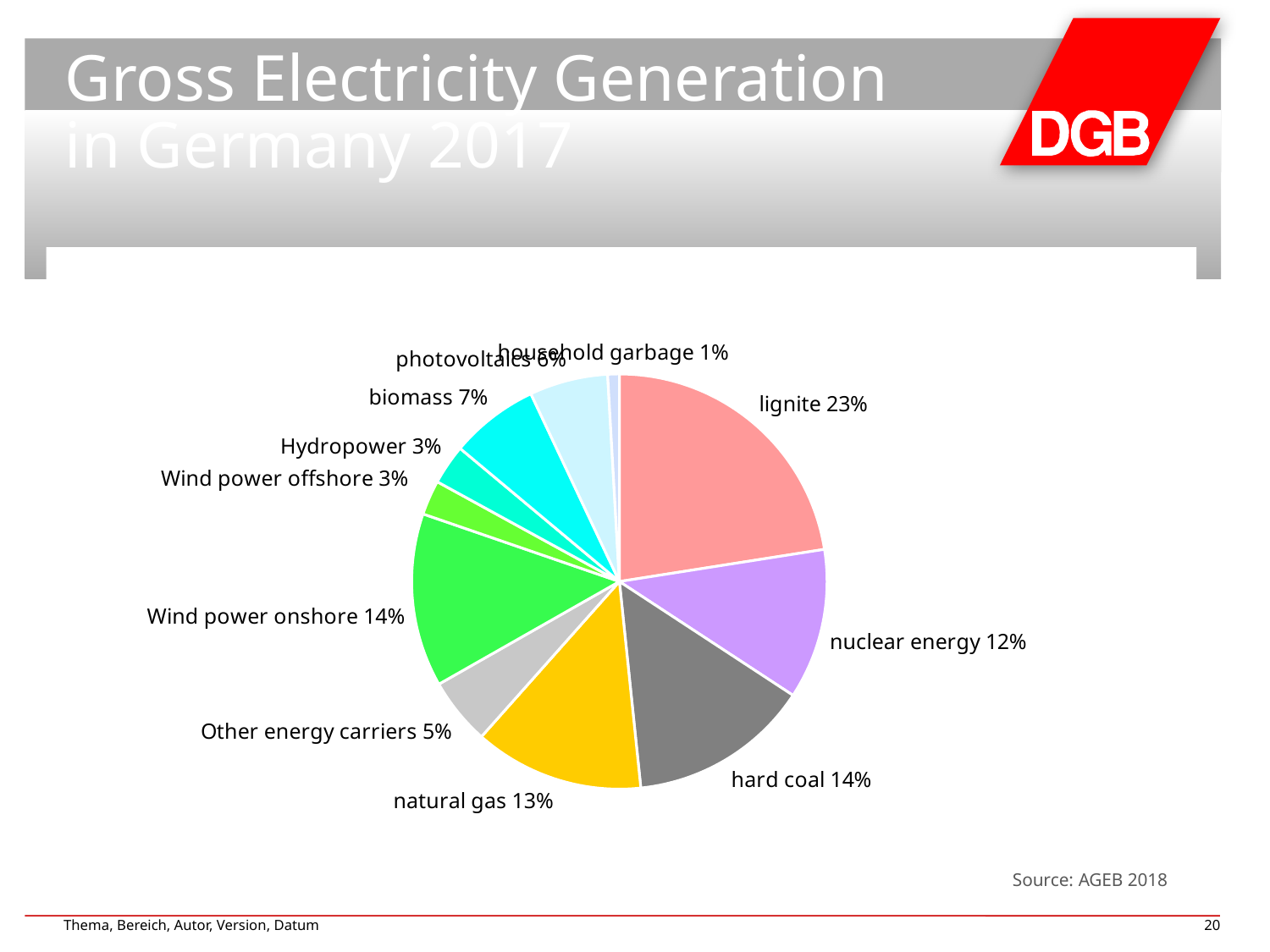
What is the value shown for nuclear energy? 12% What is the title of the slide containing the chart? Gross Electricity Generation in Germany 2017 What is the difference between the shares of lignite and hard coal? 9% What kind of chart is shown on the slide? pie chart What percentage is shown for natural gas? 13% How many slices does the pie chart have? 11 What share of gross electricity generation does lignite account for? 23% Which is larger, the share of natural gas or the share of nuclear energy? natural gas What is the value for Wind power onshore? 14% Which energy source has the smallest slice of the pie? household garbage Which energy source has the largest slice of the pie? lignite What percentage is shown for biomass? 7%